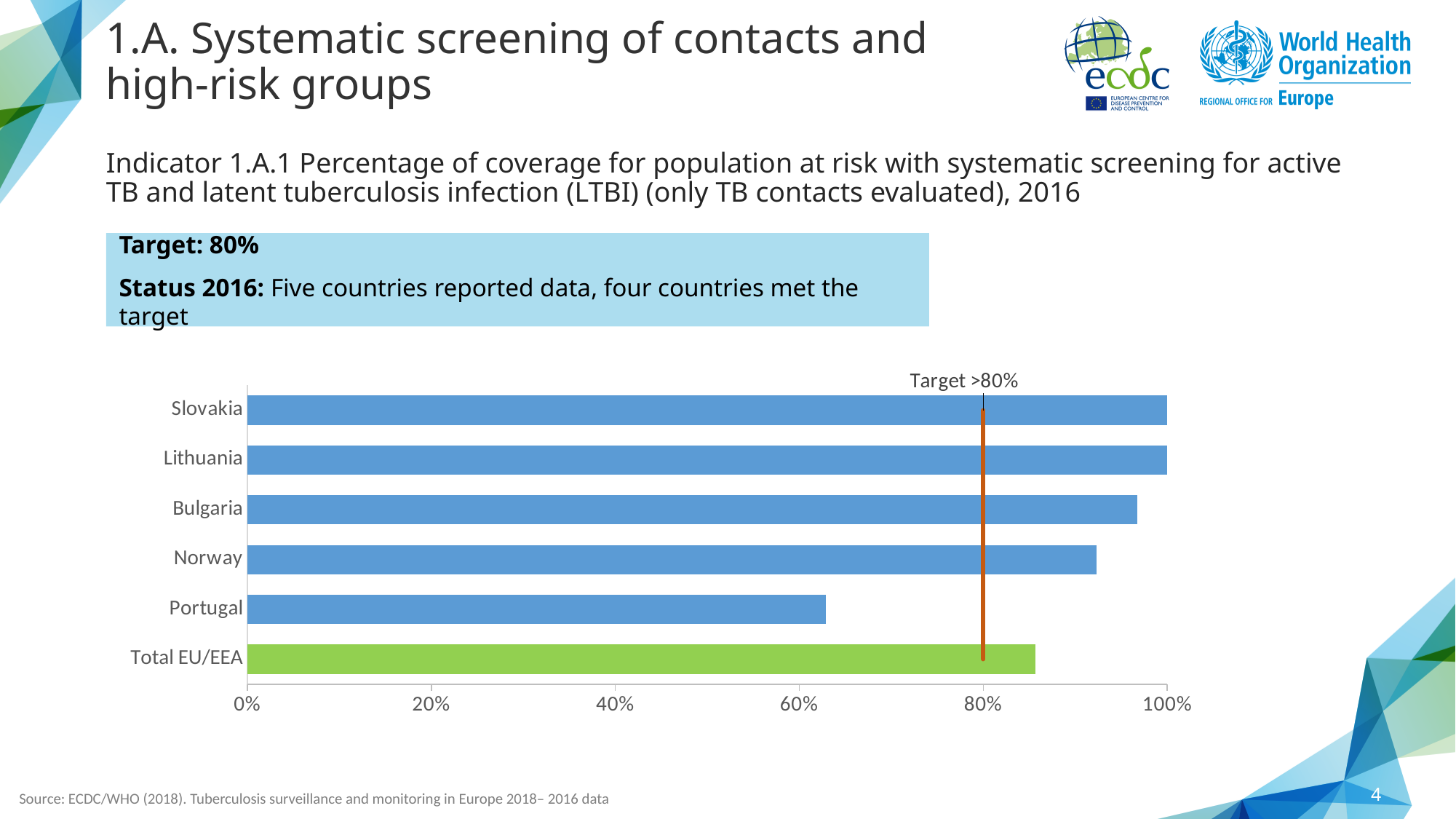
Which bar in the chart is coloured green rather than blue? Total EU/EEA What kind of chart is shown on the slide? Bar chart Which country has the lowest screening coverage in the chart? Portugal Is the value for Total EU/EEA greater or less than 80%? greater Which has the higher coverage, Bulgaria or Norway? Bulgaria What target value is marked by the vertical line on the chart? Target >80% Is the value for Portugal greater or less than 80%? less Is the value for Bulgaria greater or less than 100%? less How many bars (categories) are plotted in the chart? 6 Which has the higher coverage, Norway or Portugal? Norway